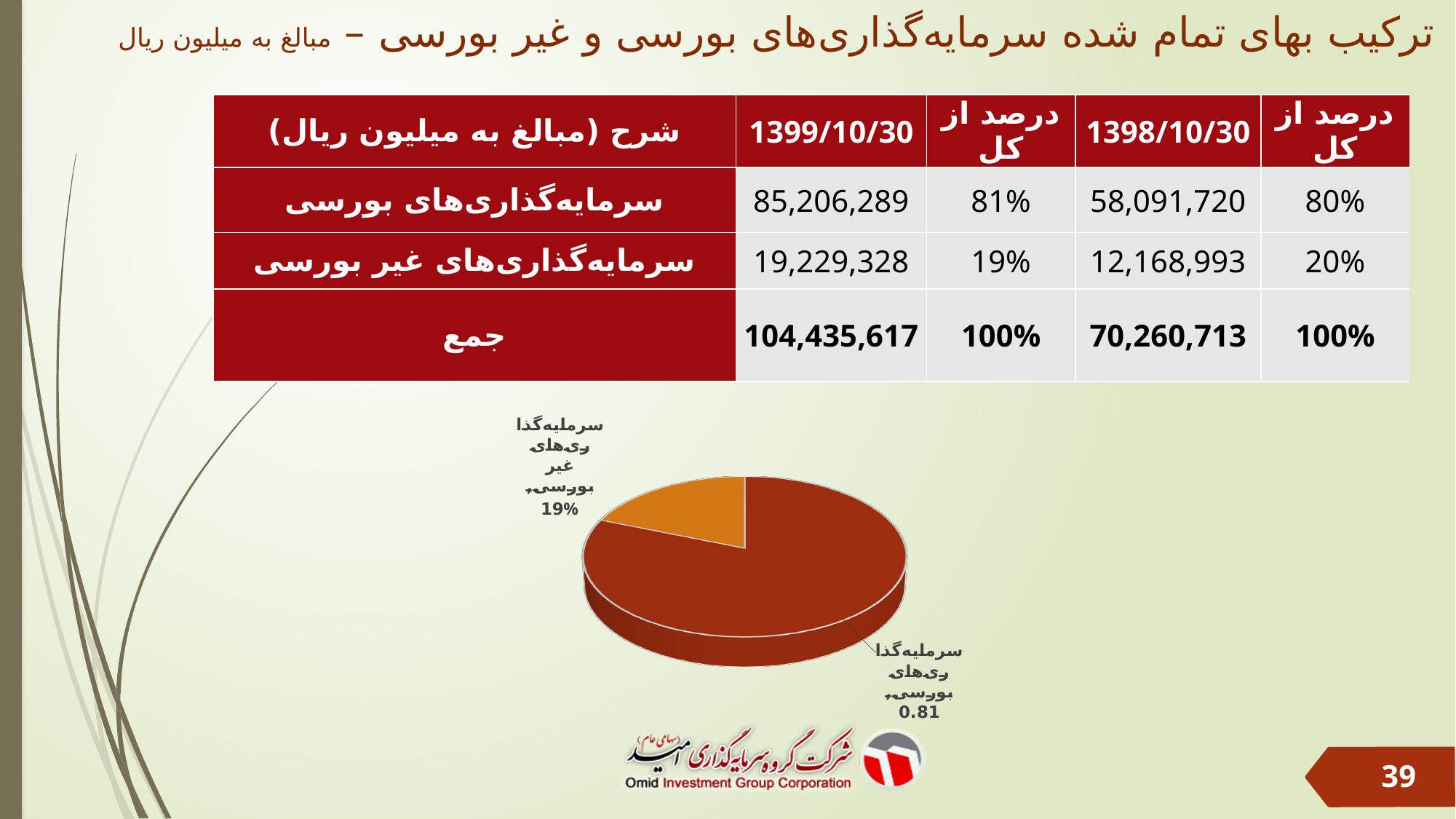
What colour is the slice for سرمایه‌گذاری‌های بورسی in the pie chart? dark red How many slices does the pie chart have? 2 Which category has the smallest slice in the pie chart? سرمایه‌گذاری‌های غیر بورسی Which category has the largest slice in the pie chart? سرمایه‌گذاری‌های بورسی What value is labelled on the pie slice for سرمایه‌گذاری‌های غیر بورسی? 19% What kind of chart is shown on the slide? pie chart What colour is the slice for سرمایه‌گذاری‌های غیر بورسی in the pie chart? orange What value is labelled on the pie slice for سرمایه‌گذاری‌های بورسی? 0.81 In the pie chart, which slice is larger: سرمایه‌گذاری‌های بورسی or سرمایه‌گذاری‌های غیر بورسی? سرمایه‌گذاری‌های بورسی